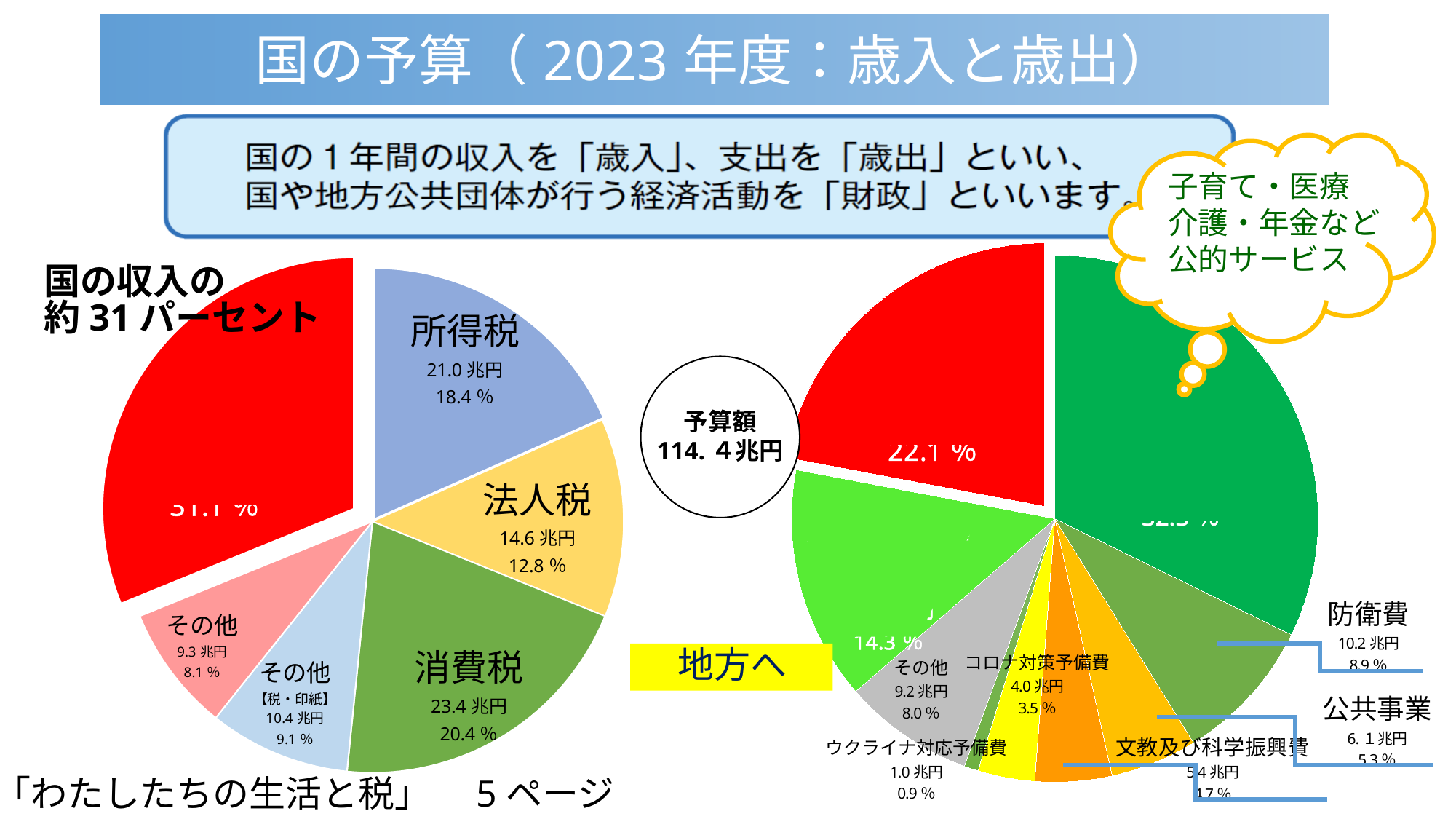
In the right pie chart (歳出), what amount is shown for コロナ対策予備費? 4.0 兆円 In the left pie chart (歳入), what percentage is shown for その他【税・印紙】? 9.1 % In the left pie chart (歳入), what is the difference in 兆円 between 消費税 and 所得税? 2.4 兆円 What total budget amount (予算額) is shown in the circle next to the right pie chart? 114.4 兆円 In the right pie chart (歳出), which is larger, 防衛費 or 文教及び科学振興費? 防衛費 In the left pie chart (歳入), what amount is shown for 所得税? 21.0 兆円 In the left pie chart (歳入), which is larger, 消費税 or 所得税? 消費税 In the right pie chart (歳出), what amount is shown for 防衛費? 10.2 兆円 In the left pie chart (歳入), what percentage share does 法人税 have? 12.8 % In the right pie chart (歳出), what percentage share does 公共事業 have? 5.3 % In the left pie chart (歳入), what amount is shown for 消費税? 23.4 兆円 What kind of chart is used on the left side of the slide to show the national revenue (歳入)? pie chart